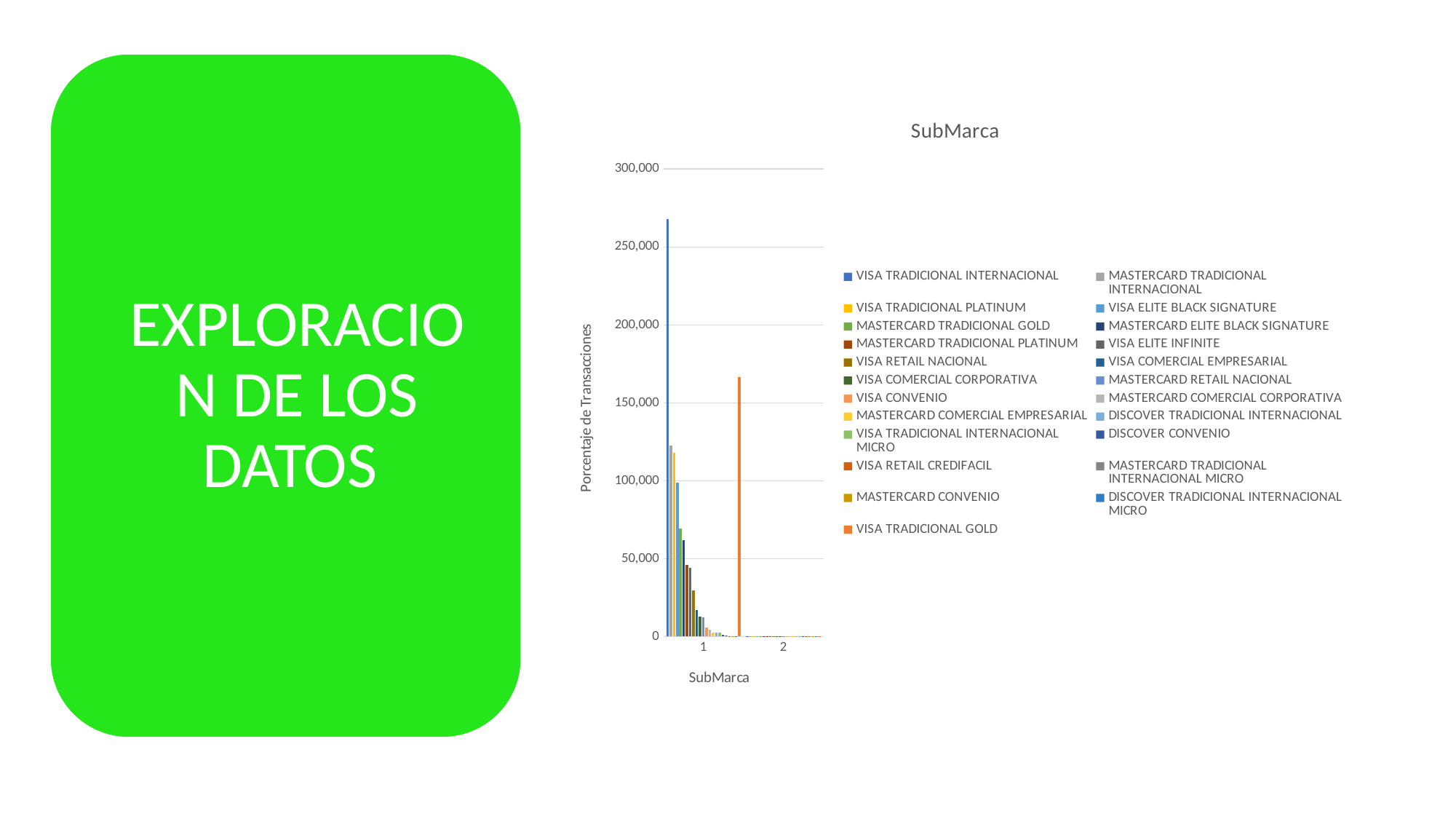
Is the value for VISA TRADICIONAL INTERNACIONAL in category 1 greater or less than 300,000? less Is the value for VISA TRADICIONAL GOLD in category 1 greater or less than 150,000? greater How many categories are shown on the x axis of the SubMarca chart? 2 Is the value for VISA TRADICIONAL GOLD in category 1 greater or less than 200,000? less How many series does the legend of the SubMarca chart list? 23 Do the bar values generally rise or fall from category 1 to category 2? fall In category 1, which is larger: VISA TRADICIONAL INTERNACIONAL or VISA TRADICIONAL GOLD? VISA TRADICIONAL INTERNACIONAL What is the title of the chart? SubMarca What kind of chart is shown on the slide? bar chart Which series has the highest bar in category 1? VISA TRADICIONAL INTERNACIONAL What is the label of the vertical axis of the chart? Porcentaje de Transacciones